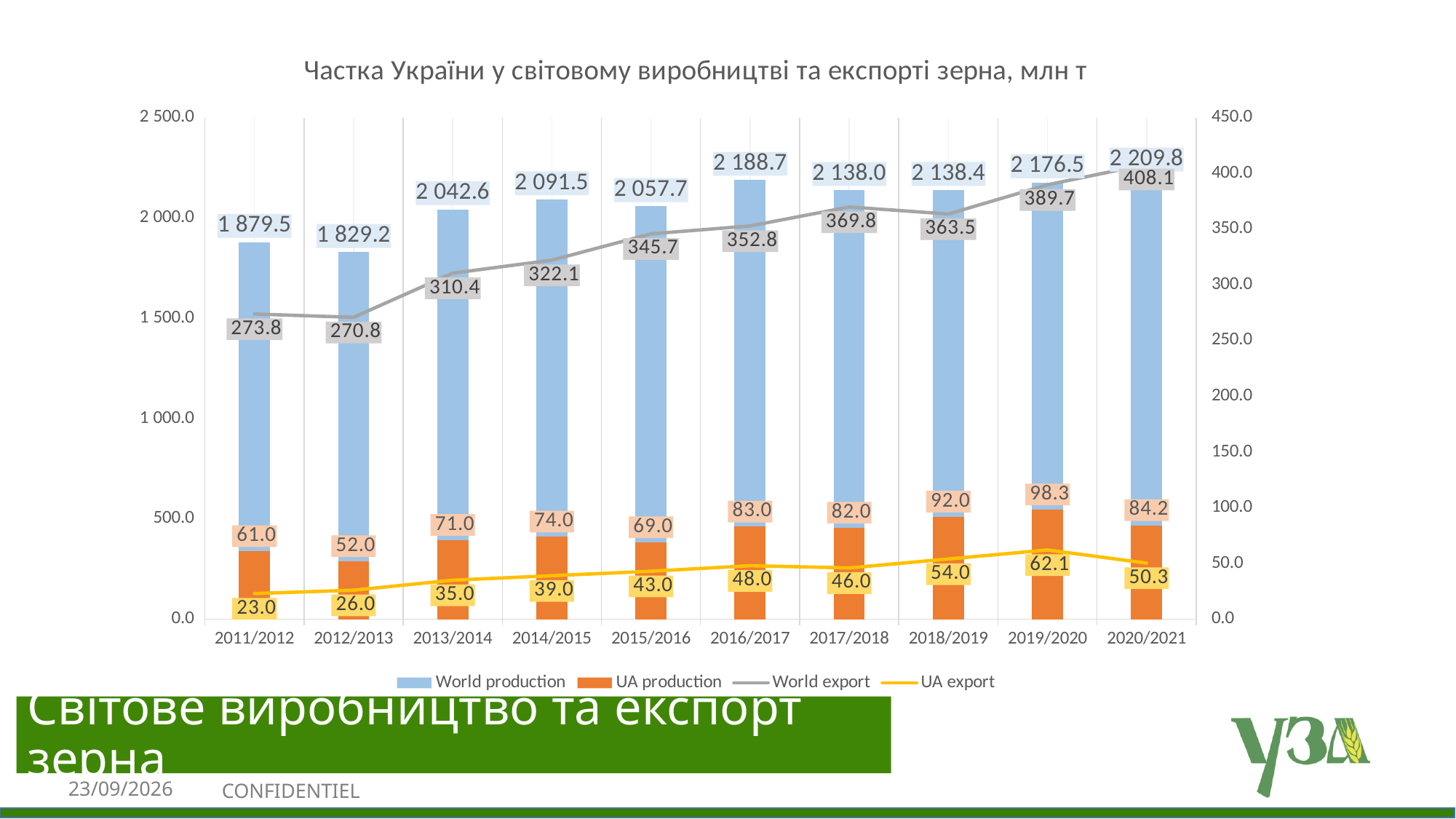
What is the difference between UA export in 2019/2020 and 2020/2021? 11.8 Which is larger: World export in 2018/2019 or in 2017/2018? 2017/2018 In which season is UA production highest? 2019/2020 Does World export generally rise or fall from 2011/2012 to 2020/2021? Rise How many seasons are shown on the x axis? 10 What is the World export value for 2017/2018? 369.8 What is the UA export value for 2013/2014? 35.0 What kind of chart is this? Combined bar and line chart What is the UA production value for 2015/2016? 69.0 What is the World production value for 2020/2021? 2 209.8 In which season is World production lowest? 2012/2013 How many series does the legend list? 4